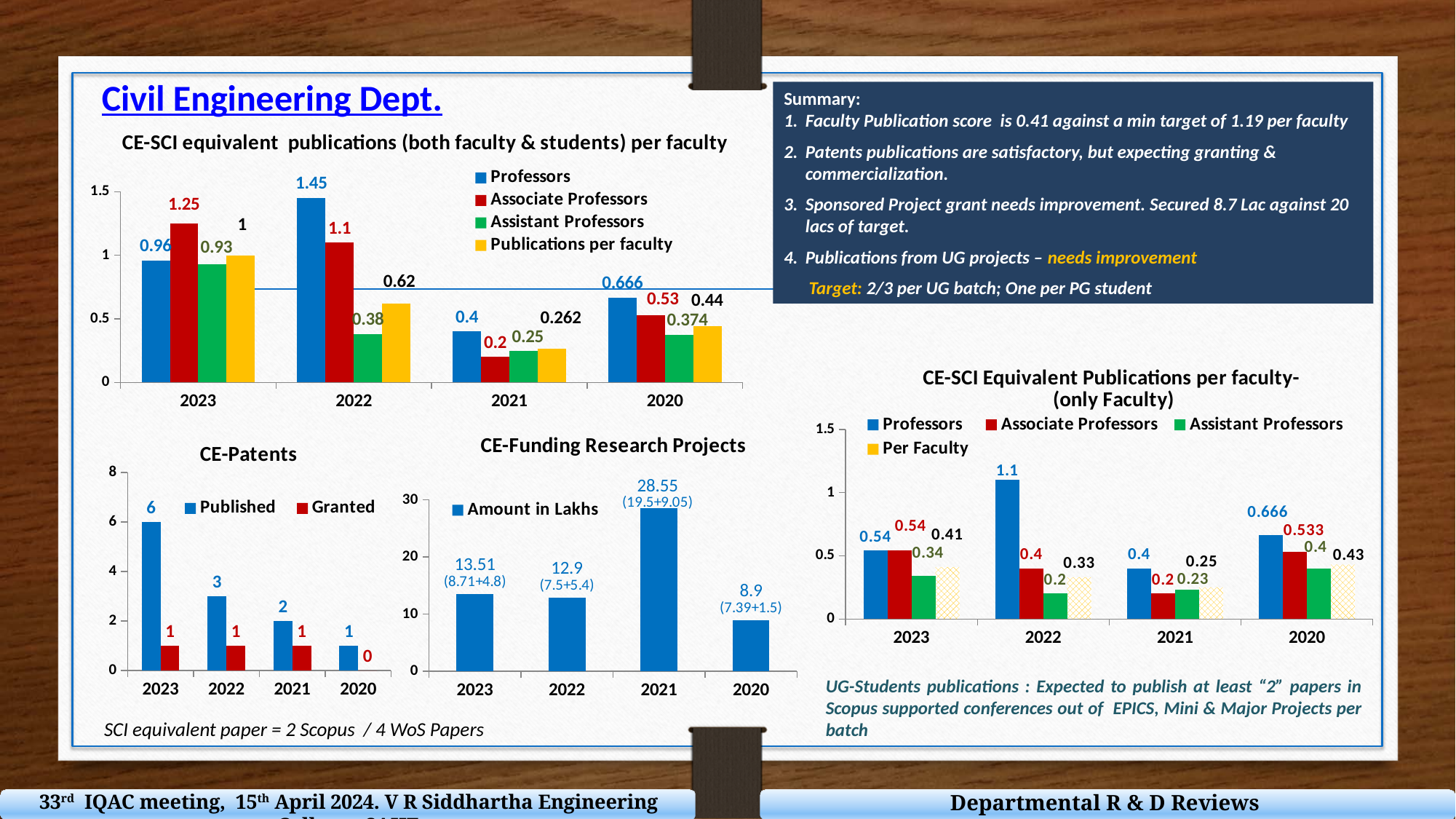
In the CE-Funding Research Projects chart, which year has the lowest amount? 2020 In the CE-Patents chart, what is the difference between published and granted patents in 2022? 2 In the CE-Patents chart, how many series does the legend list? 2 What kind of chart is the CE-Funding Research Projects chart? Bar chart In the CE-SCI equivalent publications (both faculty & students) per faculty chart, which year has the highest value for Associate Professors? 2023 In the CE-SCI Equivalent Publications per faculty (only Faculty) chart, which is larger in 2020: Associate Professors or Assistant Professors? Associate Professors In the CE-Patents chart, how many patents were published in 2023? 6 In the CE-SCI Equivalent Publications per faculty (only Faculty) chart, how many years are shown on the x axis? 4 In the CE-SCI equivalent publications (both faculty & students) per faculty chart, is the value for Assistant Professors in 2022 greater or less than 0.5? less In the CE-SCI equivalent publications (both faculty & students) per faculty chart, what is the value for Professors in 2022? 1.45 In the CE-Funding Research Projects chart, what is the amount in lakhs for 2021? 28.55 In the CE-SCI Equivalent Publications per faculty (only Faculty) chart, what is the value for Professors in 2022? 1.1